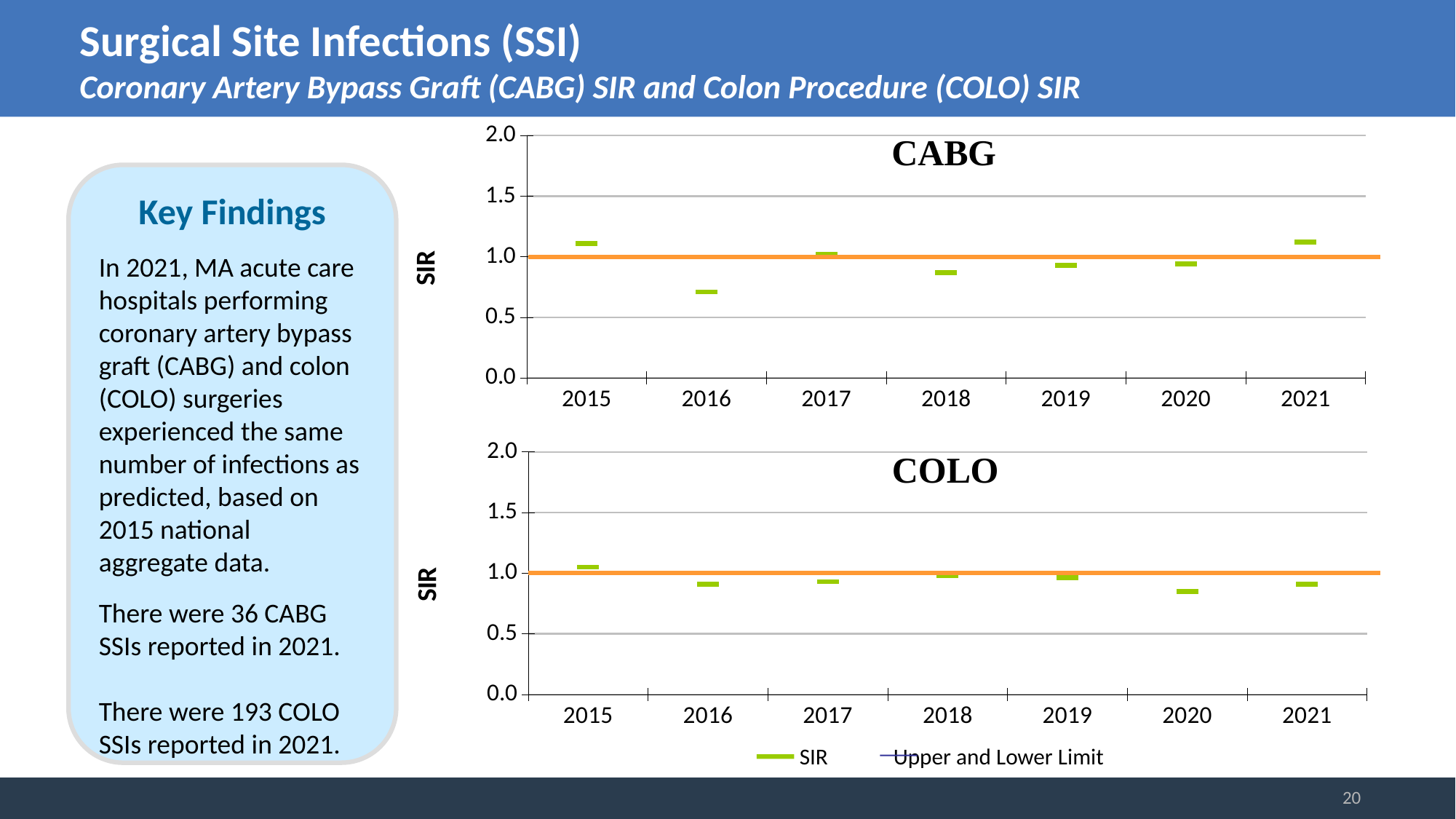
How many series does the legend below the COLO chart list? 2 In the CABG chart, is the SIR value for 2021 greater or less than 1.0? greater In the COLO chart, which year has the larger SIR, 2015 or 2020? 2015 In the COLO chart, which year has the highest SIR? 2015 How many years are plotted on the x axis of the CABG chart? 7 In the COLO chart, which year has the lowest SIR? 2020 In the CABG chart, is the SIR value for 2018 greater or less than 1.0? less In the CABG chart, which year has the larger SIR, 2016 or 2021? 2021 In the COLO chart, is the SIR value for 2020 greater or less than 1.0? less In the CABG chart, which year has the lowest SIR? 2016